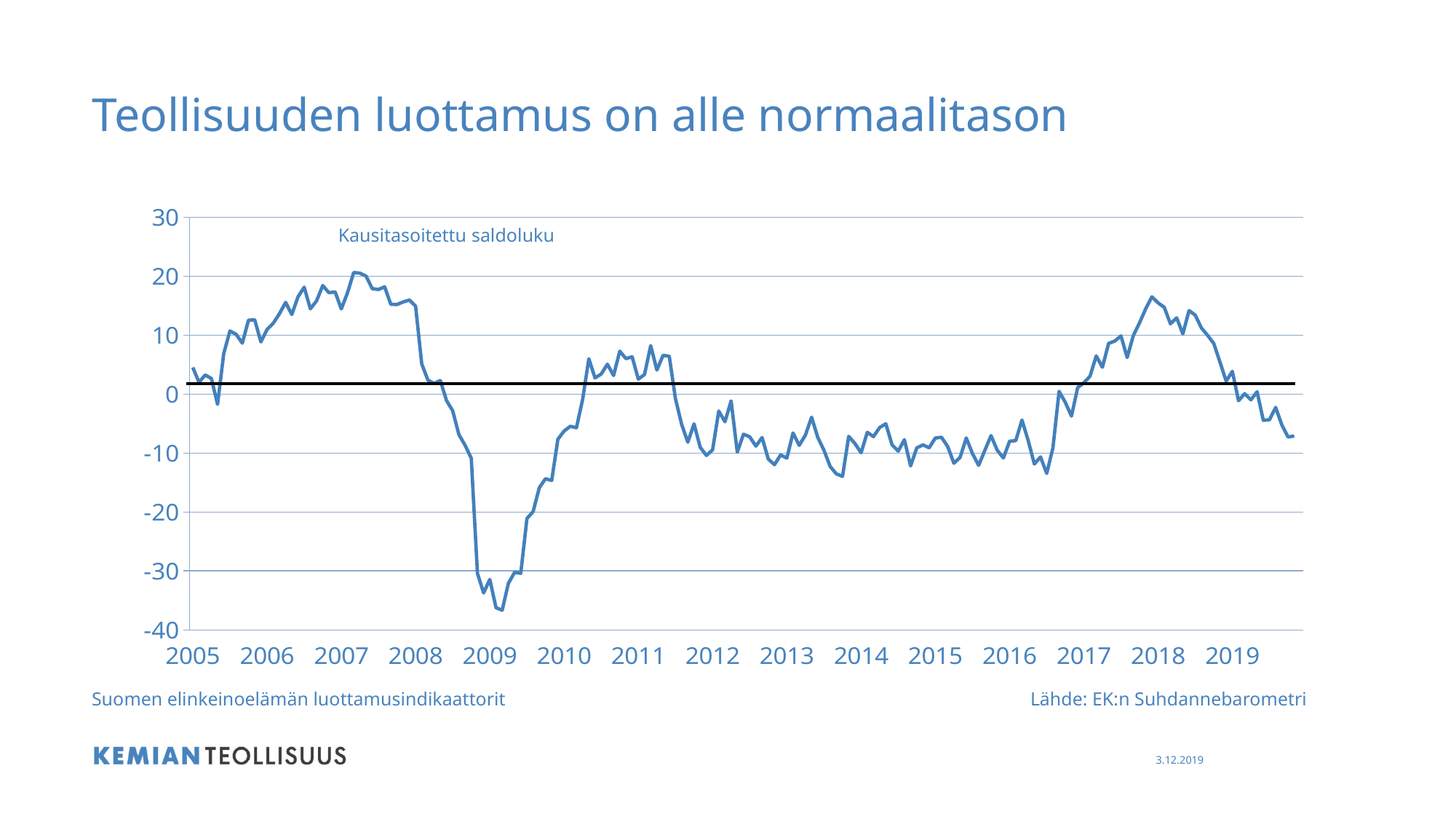
Is the value of the line during 2014 greater or less than 0? less What label is printed inside the chart area describing the plotted series? Kausitasoitettu saldoluku How many year labels are shown on the x axis? 15 Is the value at the end of 2019 greater or less than 0? less What kind of chart is shown on the slide? line chart Is the highest value of the line in 2007 greater or less than 10? greater In which year does the line reach its lowest point? 2009 In which year does the line reach its highest point? 2007 Which peak is higher, the one in 2007 or the one in 2018? 2007 Does the line rise or fall from the start of 2018 to the end of 2019? fall What is the title of the slide containing the chart? Teollisuuden luottamus on alle normaalitason